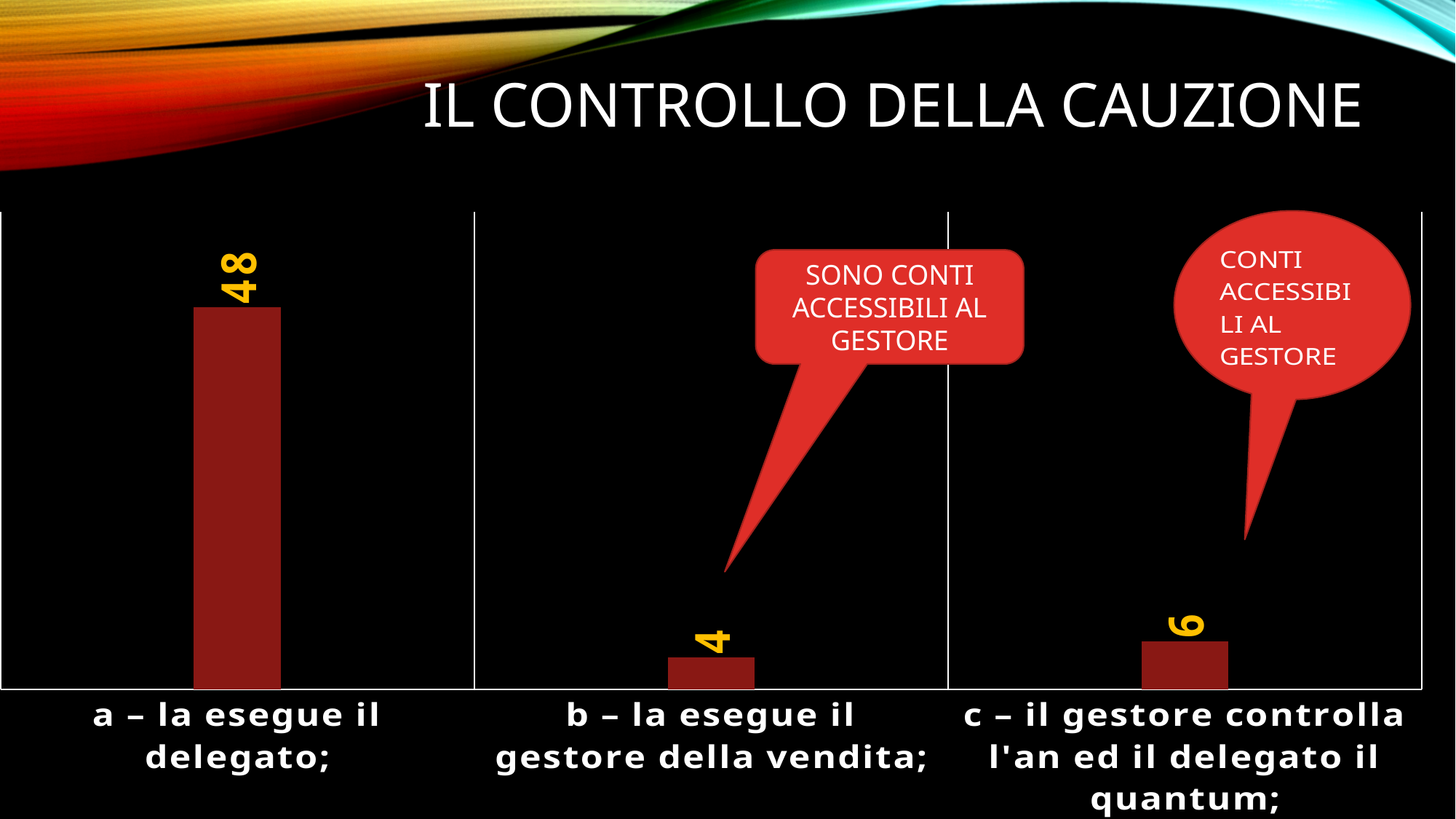
What is the title of the slide containing the chart? IL CONTROLLO DELLA CAUZIONE What is the value for the category "b – la esegue il gestore della vendita;"? 4 What is the difference between the value for "a – la esegue il delegato;" and the value for "c – il gestore controlla l'an ed il delegato il quantum;"? 42 What is the value for the category "c – il gestore controlla l'an ed il delegato il quantum;"? 6 Which category has the highest value? a – la esegue il delegato; How many categories are shown in the chart? 3 What kind of chart is shown on the slide? Bar chart What is the value for the category "a – la esegue il delegato;"? 48 What colour are the bars in the chart? Dark red What is the difference between the value for "c – il gestore controlla l'an ed il delegato il quantum;" and the value for "b – la esegue il gestore della vendita;"? 2 Which category has the lowest value? b – la esegue il gestore della vendita; Which is larger: the value for "b – la esegue il gestore della vendita;" or the value for "c – il gestore controlla l'an ed il delegato il quantum;"? c – il gestore controlla l'an ed il delegato il quantum;